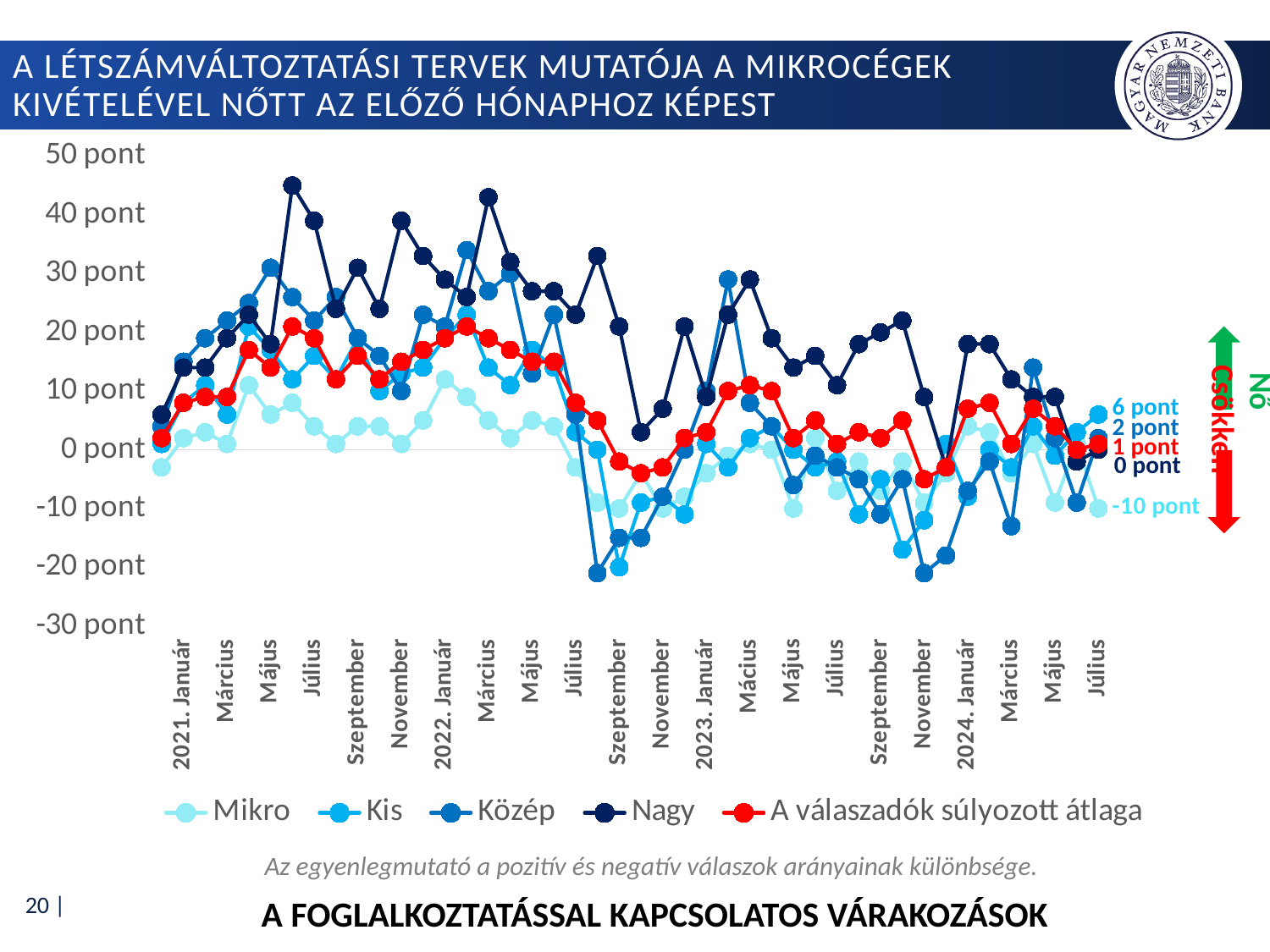
What are the series names listed in the legend? Mikro, Kis, Közép, Nagy, A válaszadók súlyozott átlaga What do the green and red arrow labels on the right side of the chart say? Nő and Csökken Is the highest value reached by 'A válaszadók súlyozott átlaga' greater or less than 30 pont? less What kind of chart is shown on the slide? Line chart At the right end of the chart, which is larger: the value of the Nagy series or the value of the Mikro series? Nagy How many series does the legend list? 5 Is the highest value reached by the Nagy series greater or less than 40 pont? greater What is the difference between the end-of-chart values of the Nagy series (0 pont) and the Mikro series (-10 pont)? 10 pont What is the latest (2024 Július) value of 'A válaszadók súlyozott átlaga', as labelled at the right end of the chart? 1 pont What is the latest (2024 Július) value of the Mikro series, as labelled at the right end of the chart? -10 pont What is the latest (2024 Július) value of the Nagy series, as labelled at the right end of the chart? 0 pont Which series has the lowest value at the right end of the chart (2024 Július)? Mikro